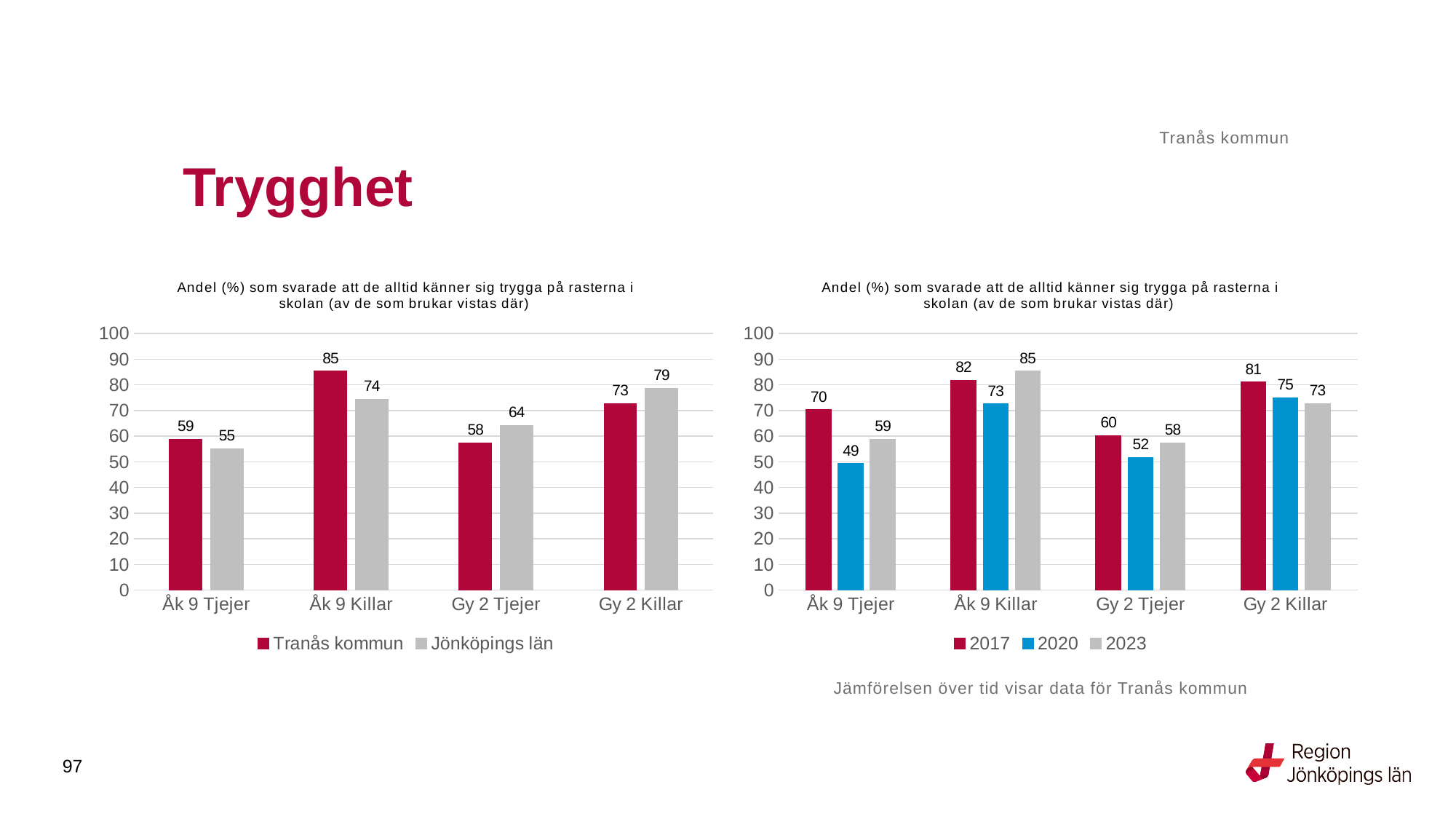
In the left chart, what is the value for Jönköpings län for Gy 2 Tjejer? 64 What kind of chart is the right chart? Bar chart In the left chart, what is the difference between Tranås kommun and Jönköpings län for Gy 2 Killar? 6 In the left chart, how many series does the legend list? 2 In the right chart, which category has the highest value for 2023? Åk 9 Killar In the left chart, which category has the lowest value for Jönköpings län? Åk 9 Tjejer In the right chart, what is the difference between 2017 and 2020 for Åk 9 Tjejer? 21 In the left chart, which is larger for Åk 9 Tjejer: Tranås kommun or Jönköpings län? Tranås kommun In the right chart, what is the value for 2020 for Åk 9 Tjejer? 49 In the right chart, what is the value for 2023 for Gy 2 Killar? 73 In the right chart, how many categories are shown on the x axis? 4 In the left chart, what is the value for Tranås kommun for Åk 9 Killar? 85